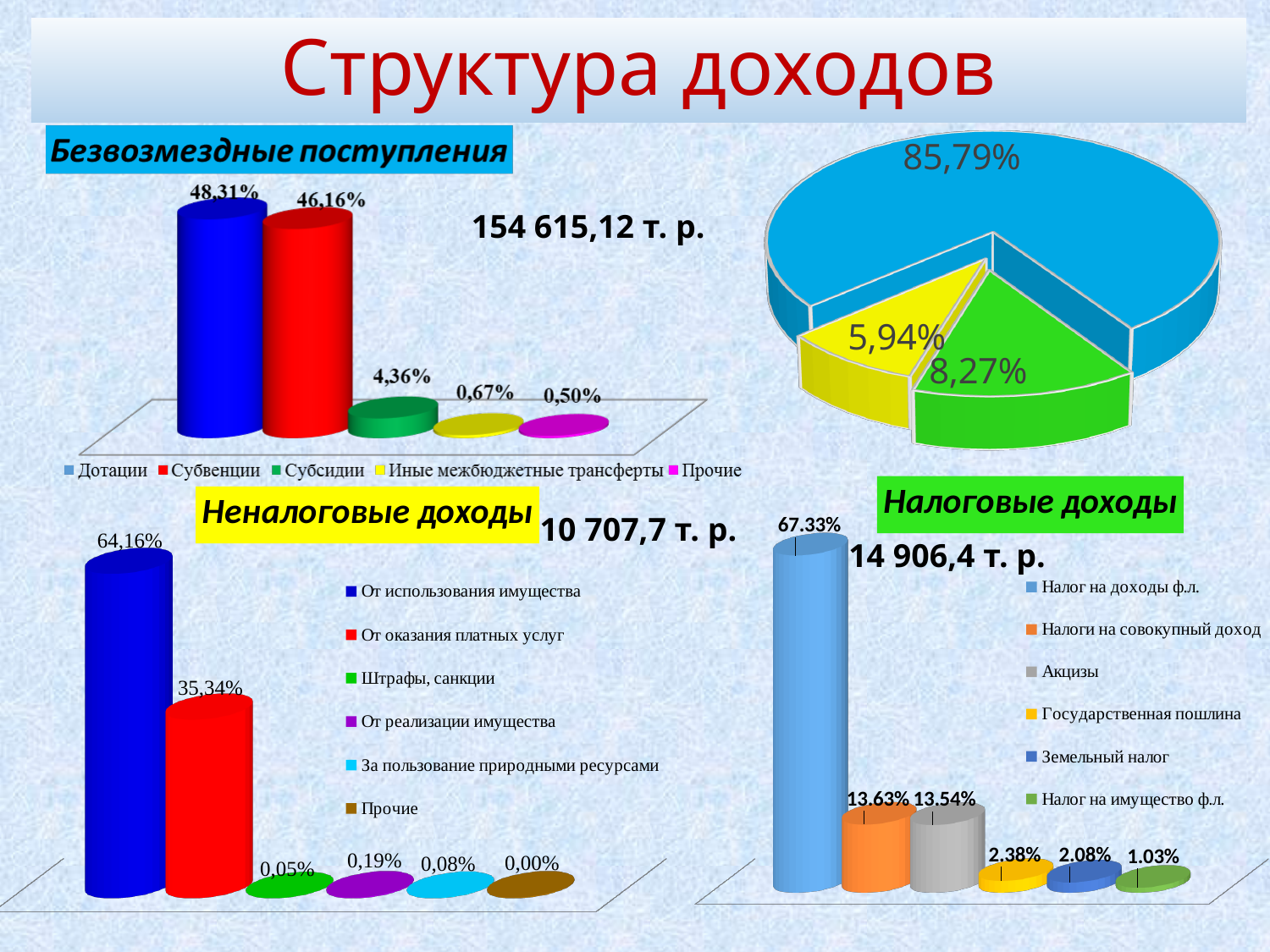
In the 'Неналоговые доходы' chart, what is the value for От оказания платных услуг? 35,34% In the 'Налоговые доходы' chart, what is the value for Налог на доходы ф.л.? 67.33% In the 'Безвозмездные поступления' chart, what is the value for Дотации? 48,31% In the pie chart at the top right of the slide, what is the value of the largest slice? 85,79% In the 'Безвозмездные поступления' chart, what is the difference between Дотации and Субвенции? 2,15% How many slices does the pie chart at the top right of the slide have? 3 In the 'Неналоговые доходы' chart, which is larger: От реализации имущества or За пользование природными ресурсами? От реализации имущества In the 'Налоговые доходы' chart, which category has the lowest value? Налог на имущество ф.л. What kind of chart is the 'Неналоговые доходы' chart? bar chart In the 'Налоговые доходы' chart, what is the difference between Налоги на совокупный доход and Акцизы? 0.09% How many series does the legend of the 'Безвозмездные поступления' chart list? 5 In the 'Безвозмездные поступления' chart, which category has the lowest value? Прочие